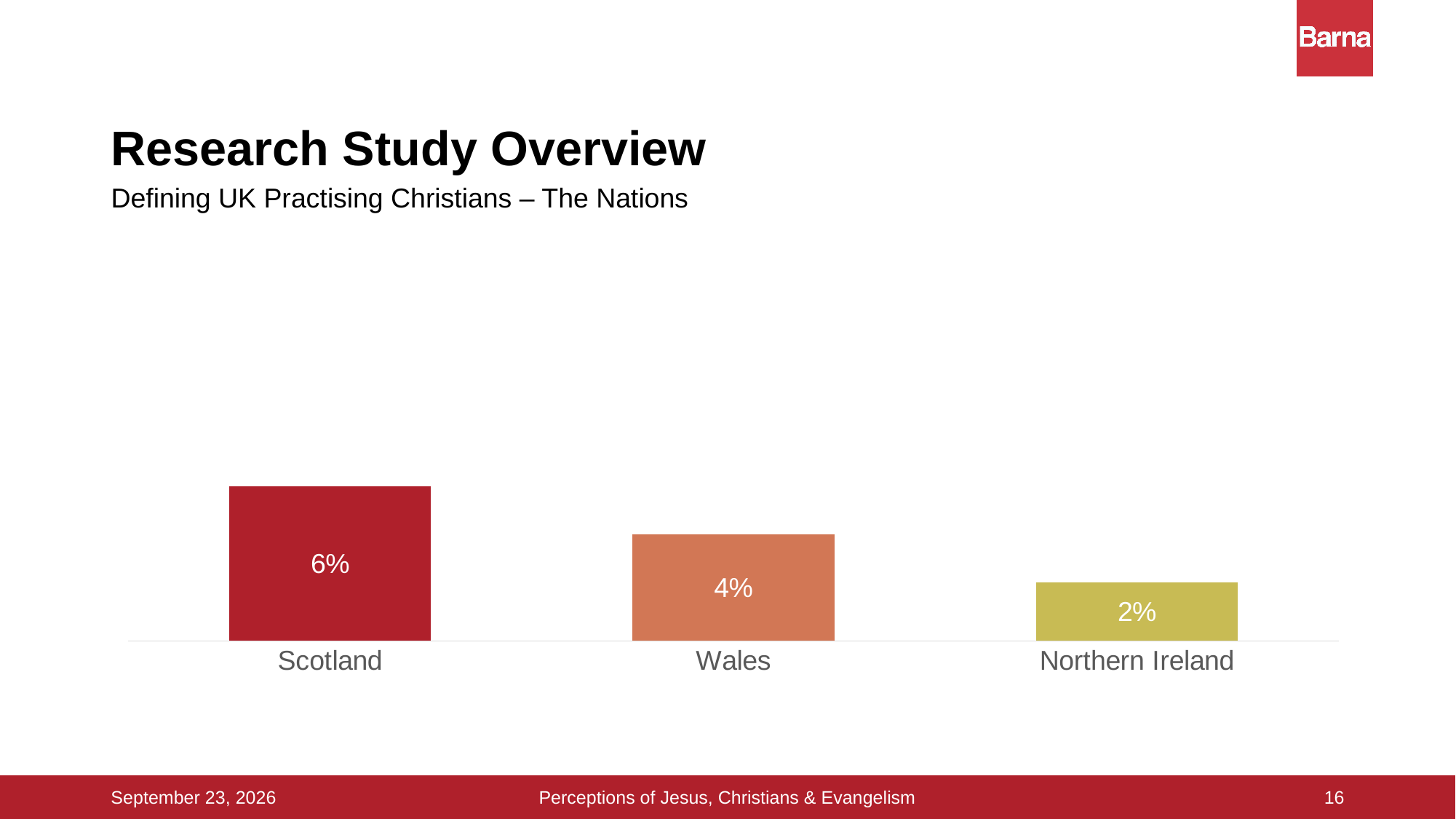
What is the value for Northern Ireland? 2% What is the value for Scotland? 6% Which is larger, the value for Wales or the value for Northern Ireland? Wales What colour is the bar for Scotland? Red Which nation has the lowest value? Northern Ireland What kind of chart is shown on the slide? Bar chart What is the value for Wales? 4% What is the difference between the values for Scotland and Northern Ireland? 4% How many nations are shown in the chart? 3 Do the values rise or fall from left to right across the chart? Fall What is the difference between the values for Scotland and Wales? 2% Which nation has the highest value? Scotland